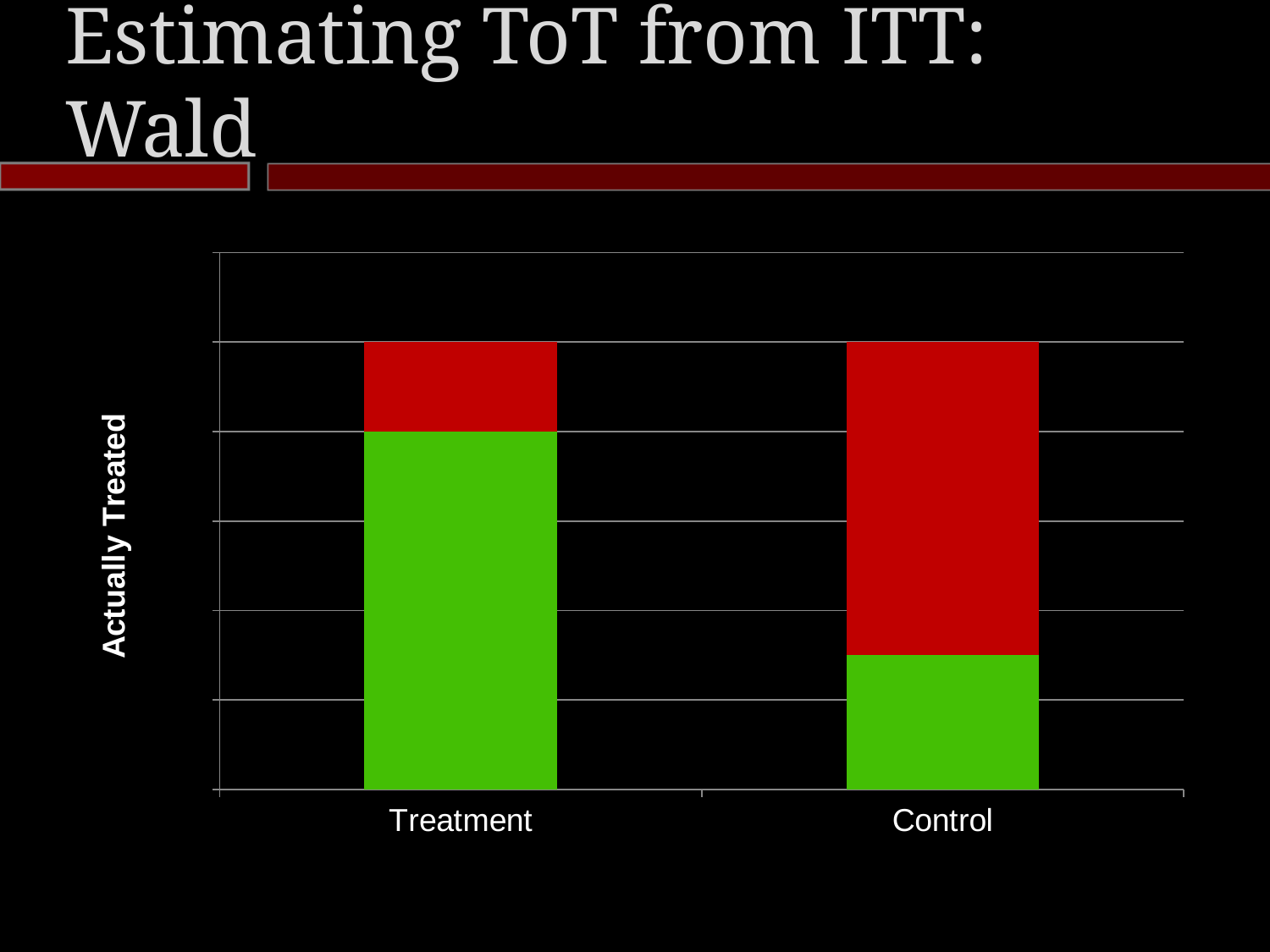
Which category has the smallest green segment? Control In the Control bar, which segment is larger, the green or the red? Red What kind of chart is shown on the slide? Stacked bar chart Which category has the larger green segment, Treatment or Control? Treatment Which category has the largest red segment? Control What is the title of the vertical axis of the chart? Actually Treated In the Treatment bar, which segment is larger, the green or the red? Green What are the two categories on the x axis of the chart? Treatment and Control How many colored segments make up each bar in the chart? 2 How many categories are shown on the x axis of the chart? 2